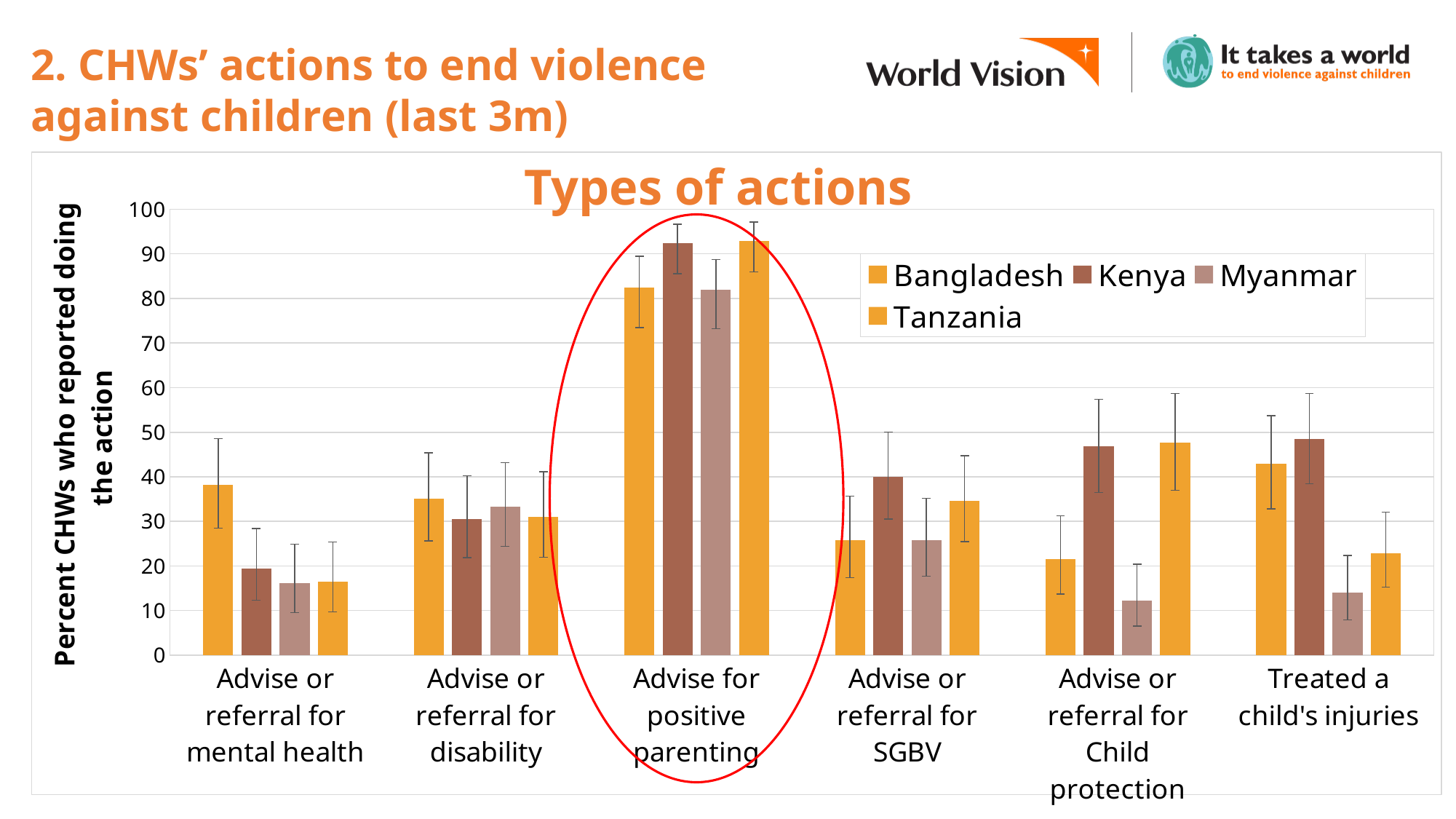
Which action category is circled in red on the chart? Advise for positive parenting Is the value for Kenya under 'Advise for positive parenting' greater or less than 80? greater Is the value for Myanmar under 'Advise or referral for Child protection' greater or less than 20? less For which action category is the Bangladesh value highest? Advise for positive parenting Under 'Advise or referral for Child protection', which is larger: Tanzania or Bangladesh? Tanzania How many series does the legend list? 4 Is the value for Bangladesh under 'Treated a child's injuries' greater or less than 40? greater For which action category is the Kenya value lowest? Advise or referral for mental health How many action categories are shown on the x axis? 6 Under 'Advise or referral for SGBV', which is larger: Kenya or Myanmar? Kenya What type of chart is shown on the slide? bar chart Under 'Advise or referral for mental health', which is larger: Bangladesh or Kenya? Bangladesh